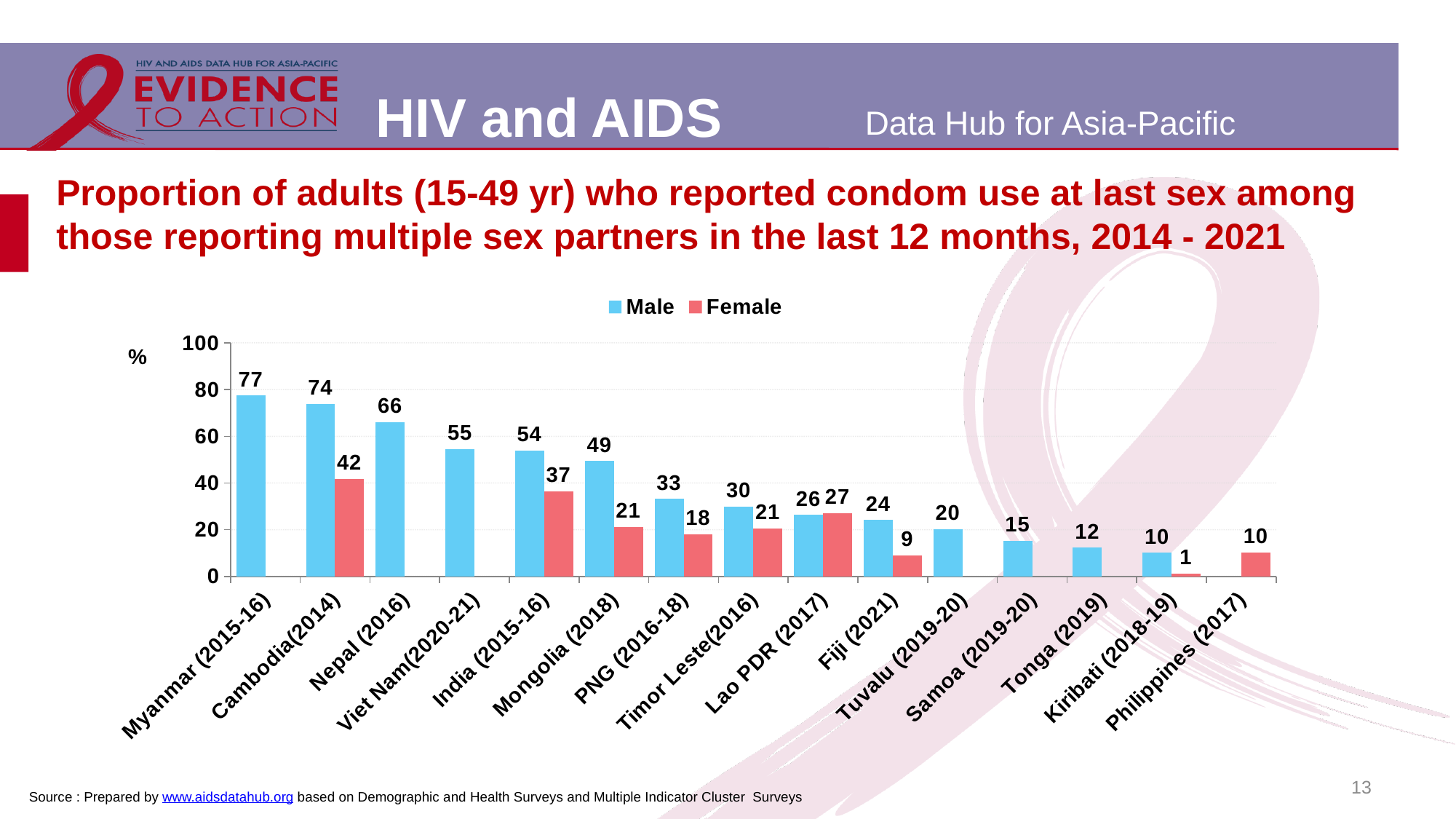
What kind of chart is shown on the slide? Bar chart How many countries are shown on the x axis? 15 Which is larger for Lao PDR (2017), the Male value or the Female value? Female Which country has the highest Male value? Myanmar (2015-16) What is the Male value for Lao PDR (2017)? 26 What is the Male value for Myanmar (2015-16)? 77 Which country has the lowest Female value? Kiribati (2018-19) What is the Female value for India (2015-16)? 37 What is the difference between the Male and Female values for Mongolia (2018)? 28 How many series does the legend list? 2 What is the Female value for Cambodia(2014)? 42 Which colour represents the Female series? Red